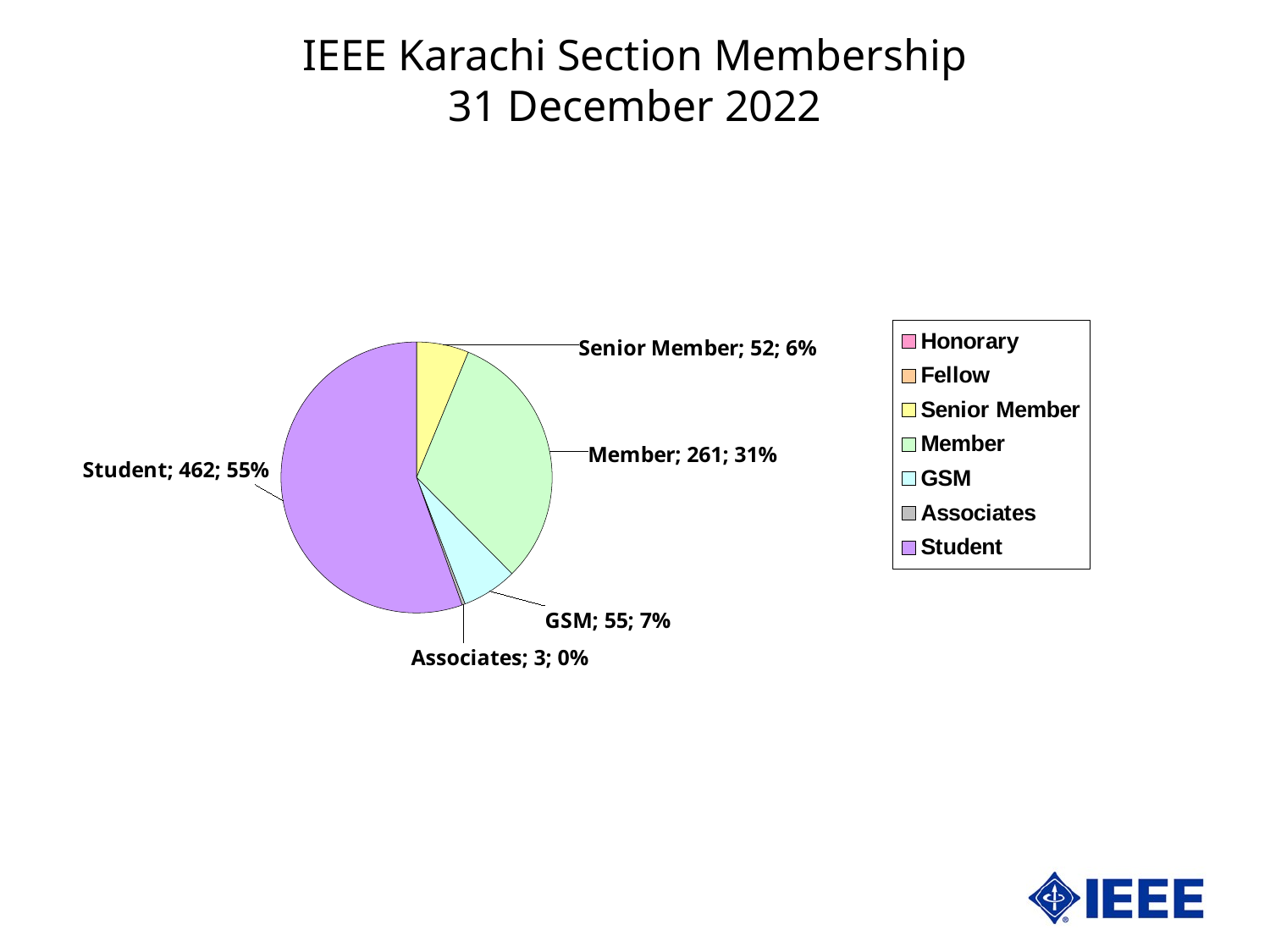
What share of the pie does the Student slice represent? 55% What is the value shown for Senior Member? 52 What percentage is shown for the Member slice? 31% What is the value shown for GSM? 55 What is the value shown for the Member slice? 261 Which is larger, the GSM value or the Senior Member value? GSM How many members are in the Student category? 462 What kind of chart is shown on the slide? Pie chart What is the difference between the Student value and the Member value? 201 Which labelled slice has the smallest value? Associates Which category has the largest slice of the pie? Student How many entries does the legend list? 7